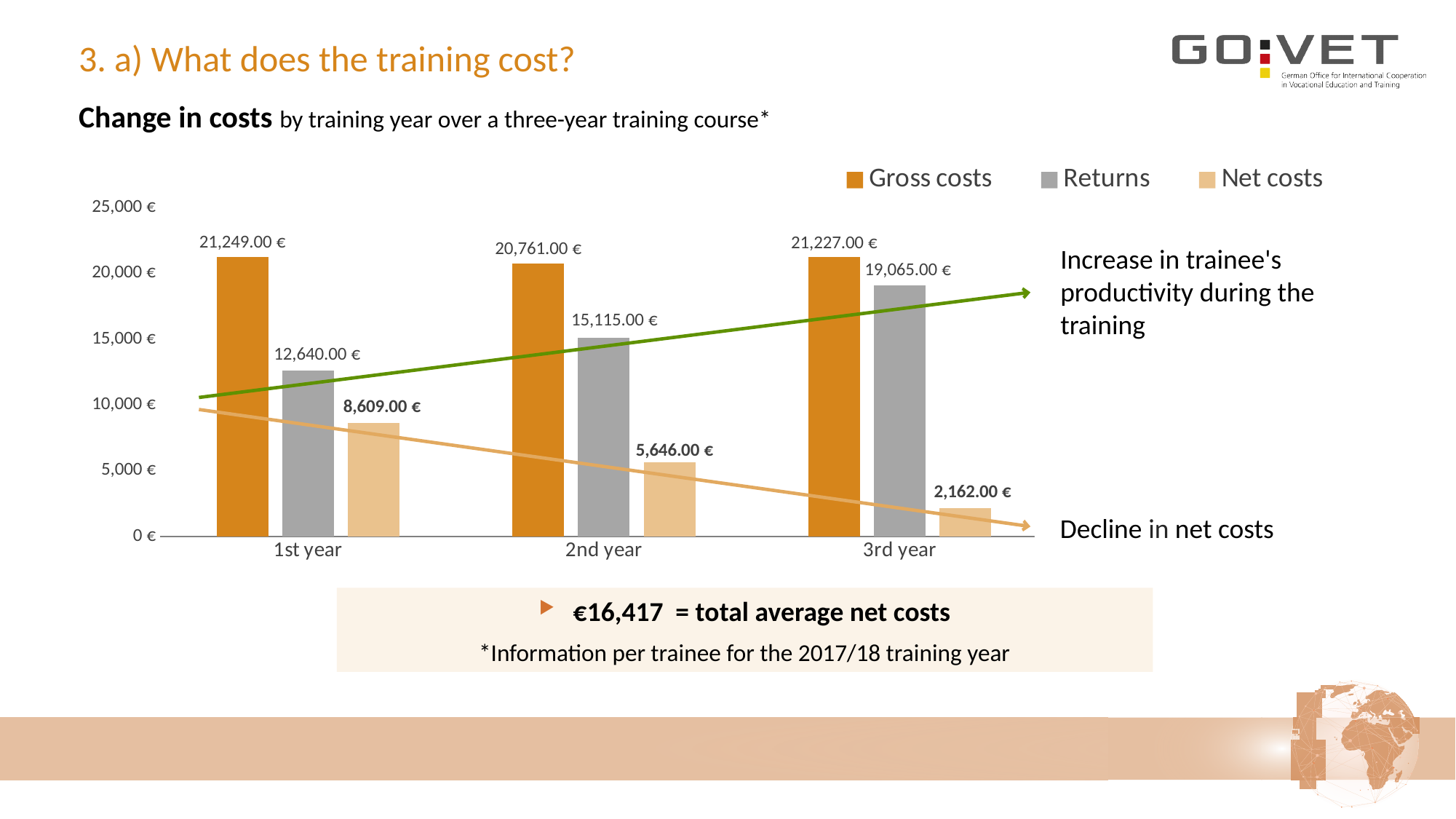
What are the returns in the 3rd year? 19,065.00 € In which training year are the returns lowest? 1st year What is the difference between gross costs and returns in the 3rd year? 2,162.00 € Do the net costs rise or fall from the 1st year to the 3rd year? Fall In which training year are the net costs highest? 1st year What are the gross costs in the 1st year? 21,249.00 € What kind of chart is shown on the slide? Bar chart How many series does the legend list? 3 What are the returns in the 2nd year? 15,115.00 € Which is larger in the 2nd year: gross costs or returns? Gross costs How many training years are shown on the x axis? 3 What are the net costs in the 3rd year? 2,162.00 €